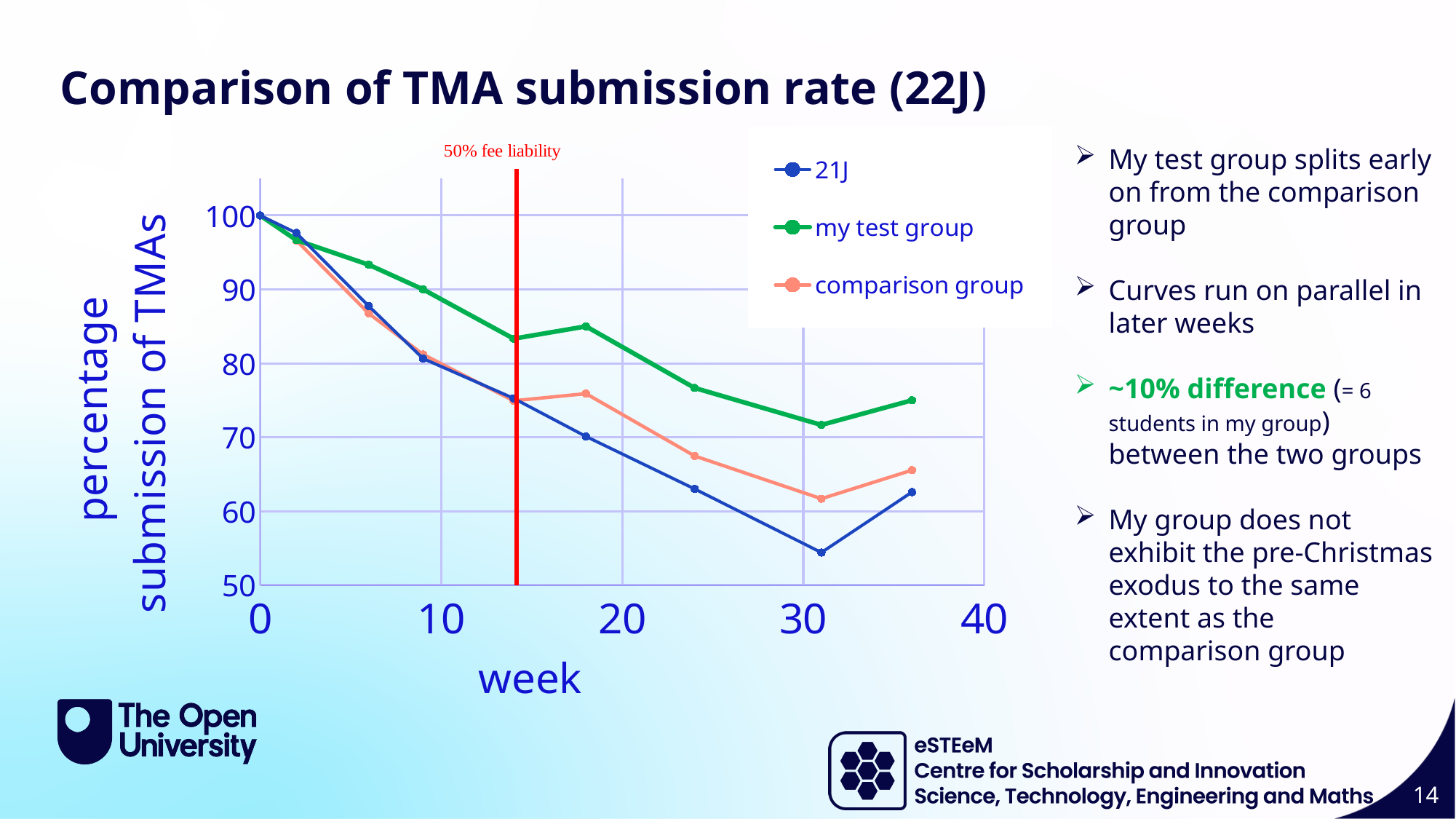
What does the red vertical line on the chart mark? 50% fee liability At around week 18, which series has the larger value: my test group or 21J? my test group What kind of chart is shown on the slide? line chart What is the label of the x axis? week Is the value for the comparison group at around week 24 greater or less than 70? less Is the value for 21J at around week 31 greater or less than 60? less What is the percentage submission of TMAs for all three series at week 0? 100 How many series does the legend list? 3 Which series has the lowest percentage submission at around week 31? 21J Is the value for my test group at around week 24 greater or less than 70? greater Do the percentage submission values generally rise or fall as the weeks increase? fall Which series has the highest percentage submission at the final plotted week (around week 36)? my test group